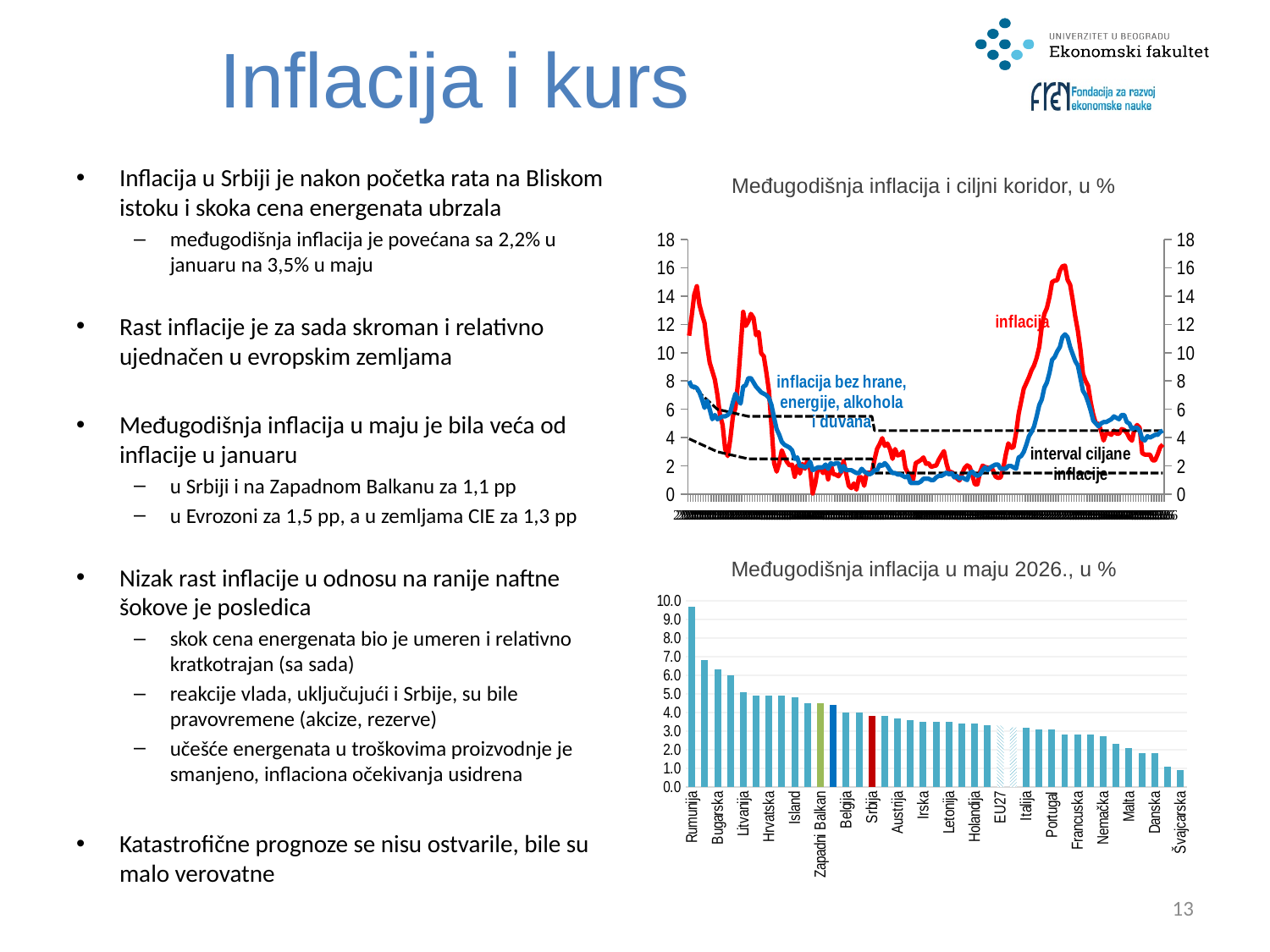
What type of chart is the chart titled 'Međugodišnja inflacija u maju 2026., u %'? bar chart In the chart 'Međugodišnja inflacija u maju 2026., u %', which country has the lowest inflation? Švajcarska In the chart 'Međugodišnja inflacija u maju 2026., u %', which country has the highest inflation? Rumunija In the chart 'Međugodišnja inflacija u maju 2026., u %', is the value for Švajcarska greater or less than 2.0? less In the chart 'Međugodišnja inflacija u maju 2026., u %', is the value for Bugarska greater or less than 6.0? greater In the chart 'Međugodišnja inflacija u maju 2026., u %', which is larger, the value for Rumunija or the value for Srbija? Rumunija In the chart 'Međugodišnja inflacija u maju 2026., u %', is the value for Rumunija greater or less than 8.0? greater In the chart 'Međugodišnja inflacija i ciljni koridor, u %', what colour is the line labelled 'inflacija'? red In the chart 'Međugodišnja inflacija u maju 2026., u %', do the values rise or fall from left to right? fall What type of chart is the chart titled 'Međugodišnja inflacija i ciljni koridor, u %'? line chart